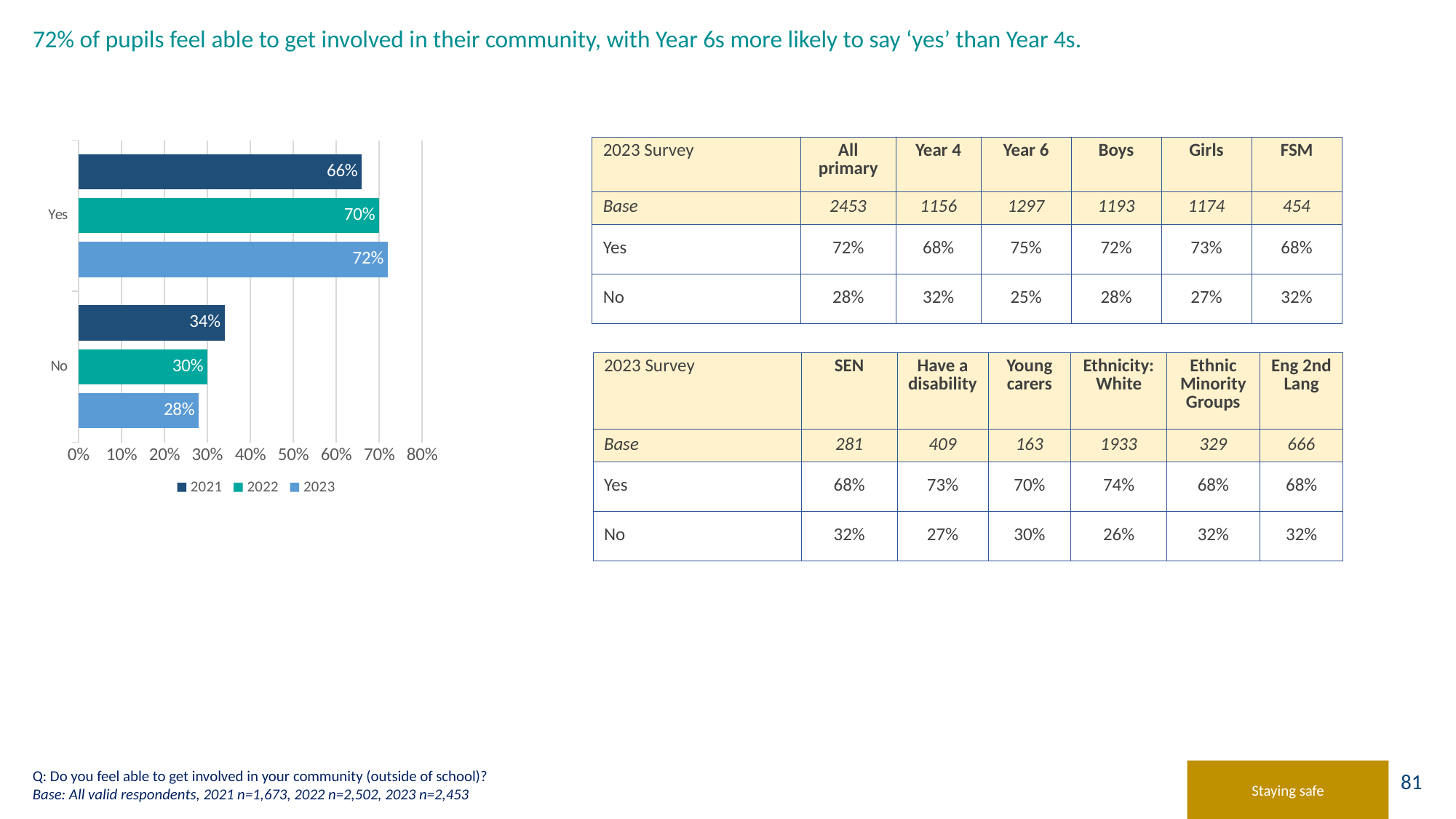
Which year has the lowest value for 'No'? 2023 How many categories are shown on the chart's vertical axis? 2 What kind of chart is shown on the slide? Bar chart What is the value for 'No' in 2021? 34% What is the difference between the 'Yes' values for 2023 and 2021? 6% Is the value for 'Yes' in 2021 greater or less than 60%? greater What is the value for 'Yes' in 2023? 72% What is the value for 'Yes' in 2022? 70% Which is larger: the 'No' value for 2021 or for 2022? 2021 Which year has the highest value for 'Yes'? 2023 How many series does the legend list? 3 Does the 'Yes' value rise or fall from 2021 to 2023? Rise